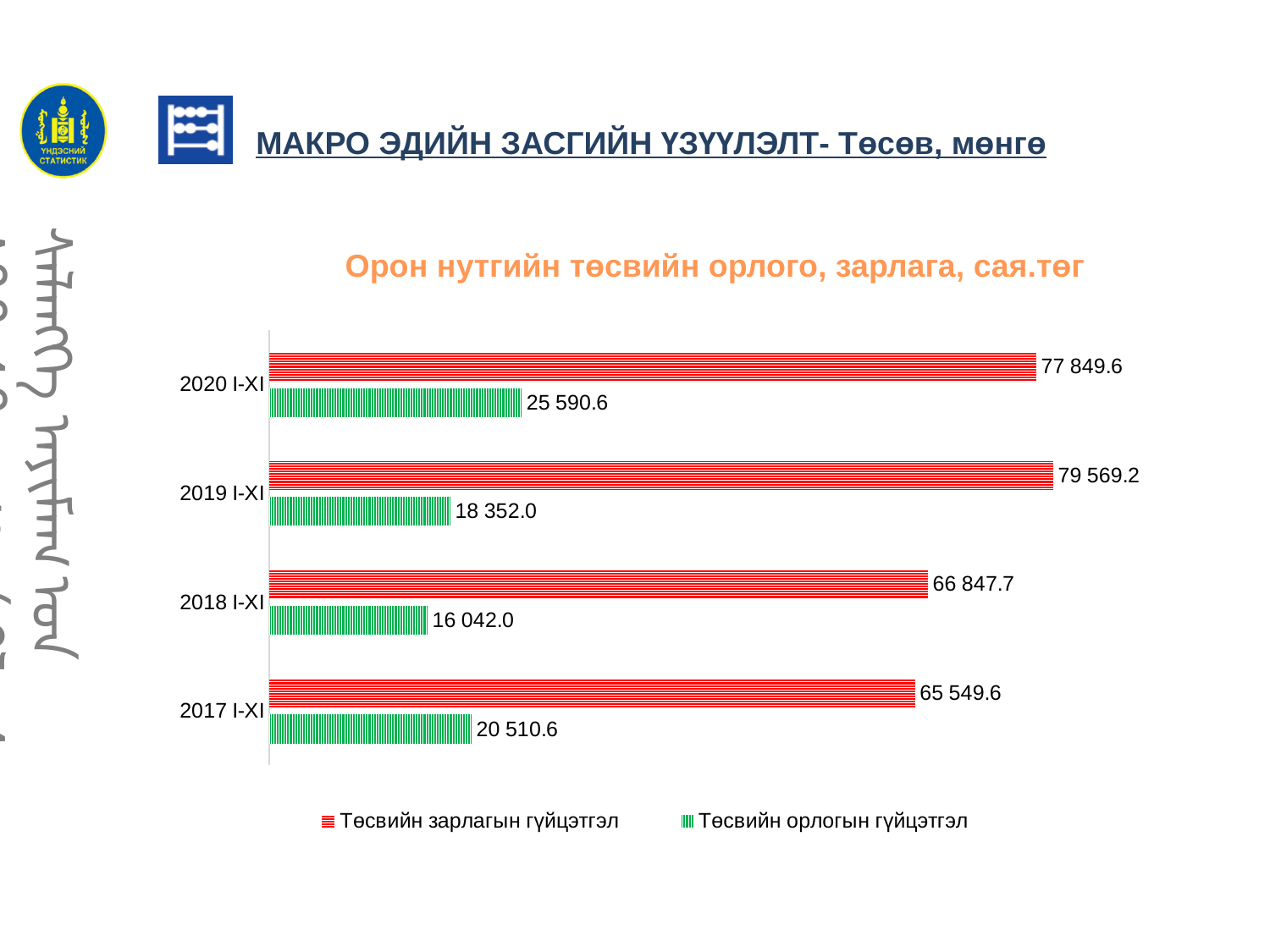
By how much did Төсвийн зарлагын гүйцэтгэл in 2019 I-XI exceed that in 2018 I-XI? 12 721.5 What is the difference between Төсвийн зарлагын гүйцэтгэл and Төсвийн орлогын гүйцэтгэл for 2020 I-XI? 52 259.0 What is the value of Төсвийн орлогын гүйцэтгэл for 2019 I-XI? 18 352.0 What is the value of Төсвийн зарлагын гүйцэтгэл for 2020 I-XI? 77 849.6 Which period has the lowest value for Төсвийн орлогын гүйцэтгэл? 2018 I-XI Which is larger: Төсвийн орлогын гүйцэтгэл for 2020 I-XI or for 2017 I-XI? 2020 I-XI How many periods are shown on the chart? 4 Which period has the highest value for Төсвийн зарлагын гүйцэтгэл? 2019 I-XI What is the value of Төсвийн орлогын гүйцэтгэл for 2017 I-XI? 20 510.6 What is the title of the chart? Орон нутгийн төсвийн орлого, зарлага, сая.төг What type of chart is shown on the slide? Bar chart How many series does the legend list? 2